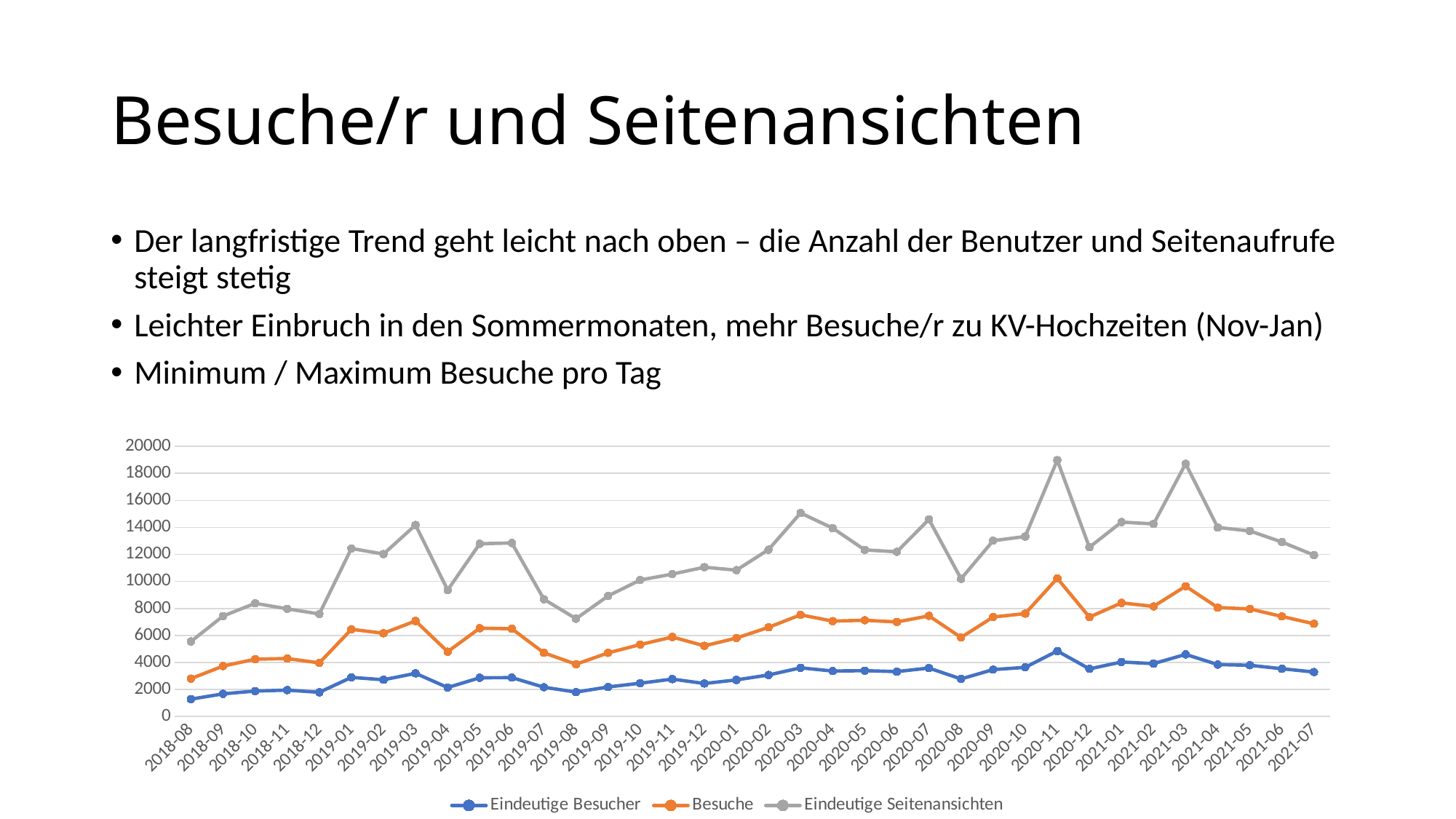
Is the value for Eindeutige Seitenansichten in 2020-11 greater or less than 18000? greater Which colour is used for the Besuche series in the legend? orange Is the value for Eindeutige Besucher in 2020-11 greater or less than 6000? less How many series does the legend list? 3 How many months are plotted along the x axis? 36 In which month is the Eindeutige Seitenansichten series at its lowest? 2018-08 Which is larger for the Besuche series: the value in 2019-03 or the value in 2019-04? 2019-03 What kind of chart is shown on the slide? line chart In which month does the Besuche series reach its highest value? 2020-11 Over the whole period from 2018-08 to 2021-07, do the Eindeutige Seitenansichten values generally rise or fall? rise In which month is the Eindeutige Besucher series at its lowest? 2018-08